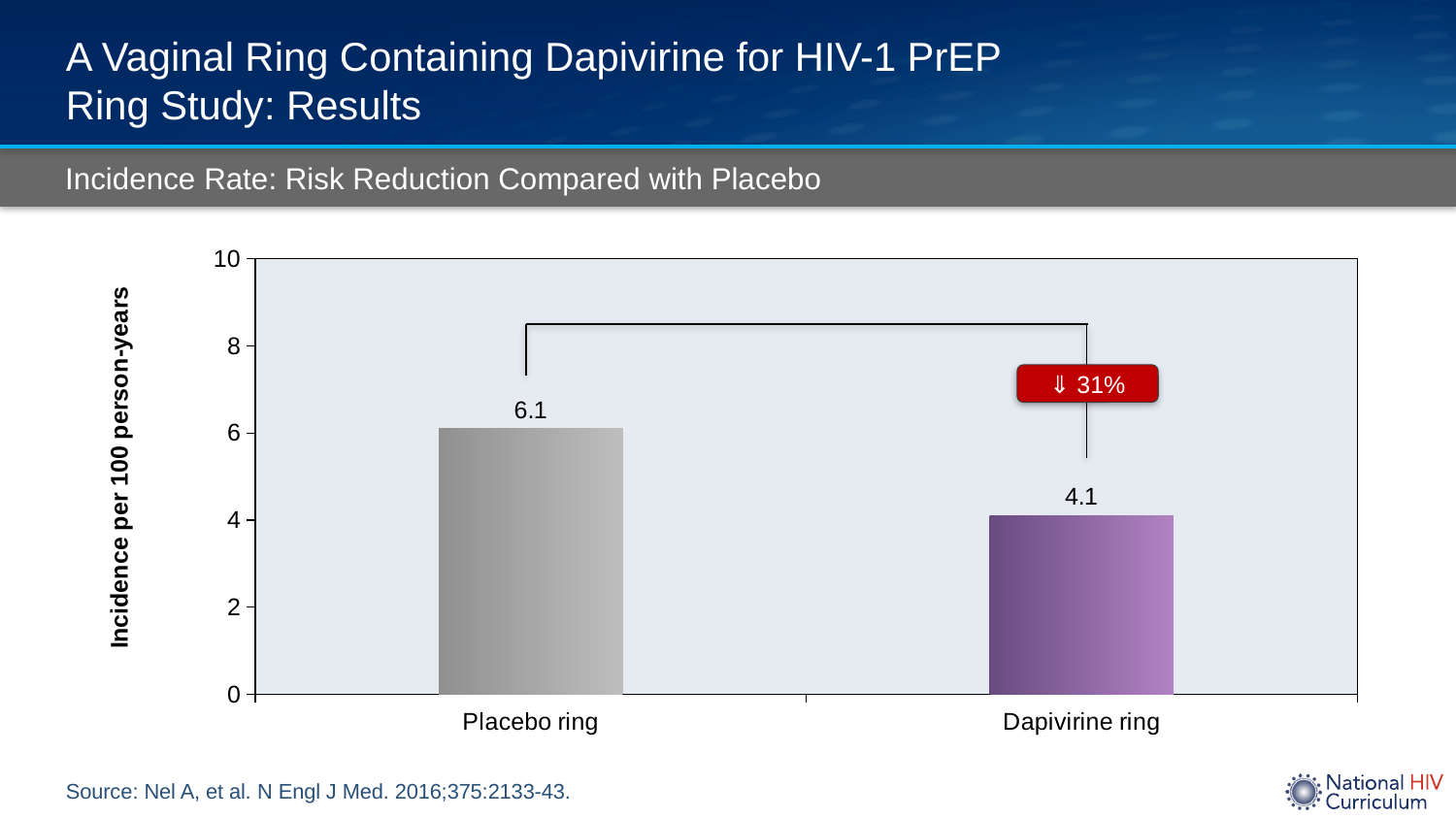
What is the incidence per 100 person-years for the Placebo ring? 6.1 Is the Dapivirine ring value larger or smaller than the Placebo ring value? smaller Which group has the lower incidence rate? Dapivirine ring Is the incidence rate for the Dapivirine ring greater or less than 6? less What kind of chart is shown on the slide? Bar chart What percentage risk reduction is shown in the red label on the chart? 31% How many categories are shown on the x axis? 2 Which group has the higher incidence rate? Placebo ring Is the incidence rate for the Placebo ring greater or less than 4? greater What is the incidence per 100 person-years for the Dapivirine ring? 4.1 What is the difference in incidence per 100 person-years between the Placebo ring and the Dapivirine ring? 2.0 What is the label of the y axis? Incidence per 100 person-years